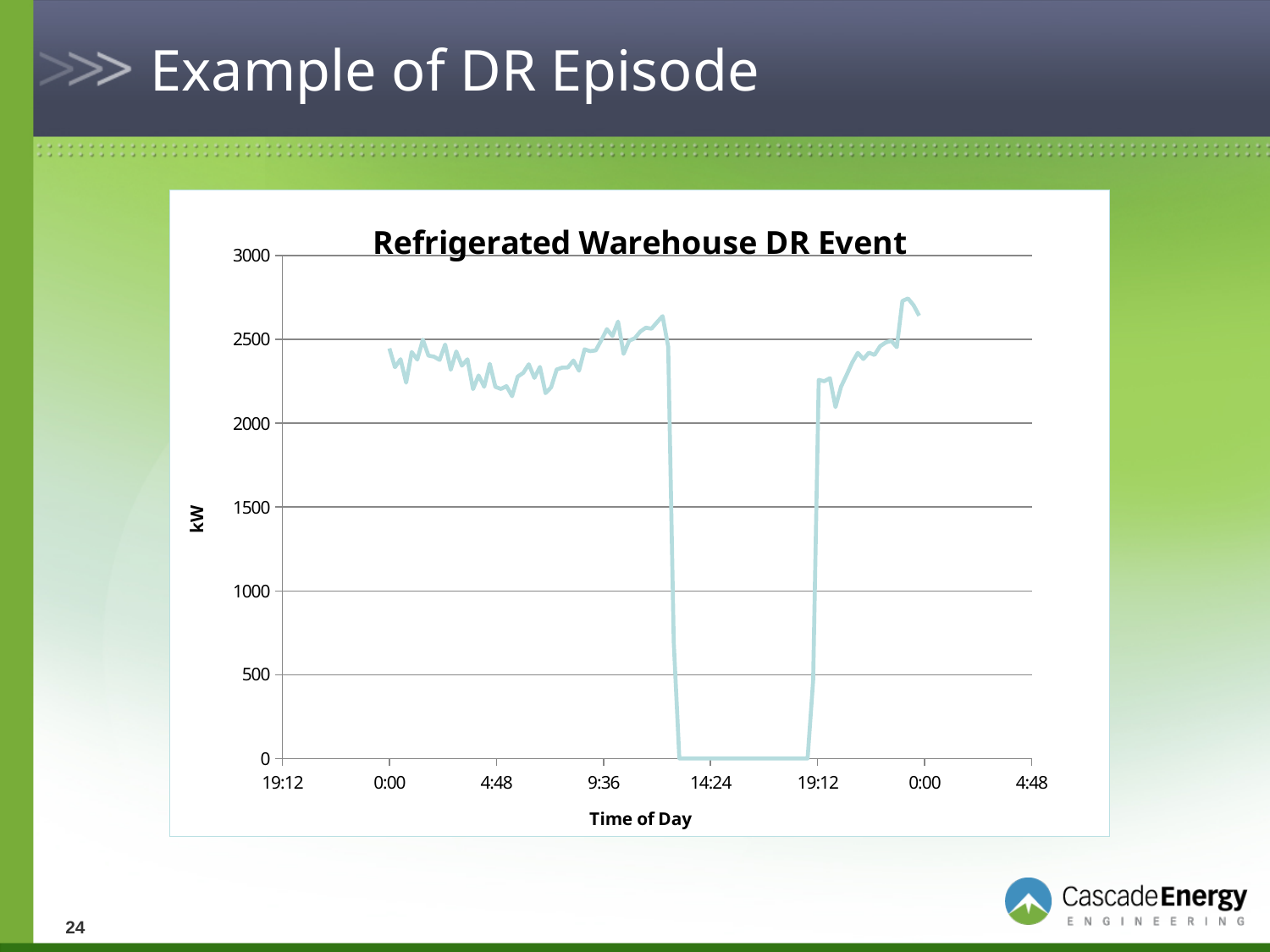
Is the value at the first 0:00 tick greater or less than 2000? greater What kind of chart is shown on the slide? Line chart Is the value at the second 0:00 tick greater or less than 2000? greater Does the line rise or fall between 9:36 and 14:24? fall What is the highest value shown on the vertical axis? 3000 What is the label on the vertical axis of the chart? kW What is the title of the chart? Refrigerated Warehouse DR Event Is the value at 9:36 greater or less than 3000? less Does the line rise or fall between the second 19:12 tick and the second 0:00 tick? rise